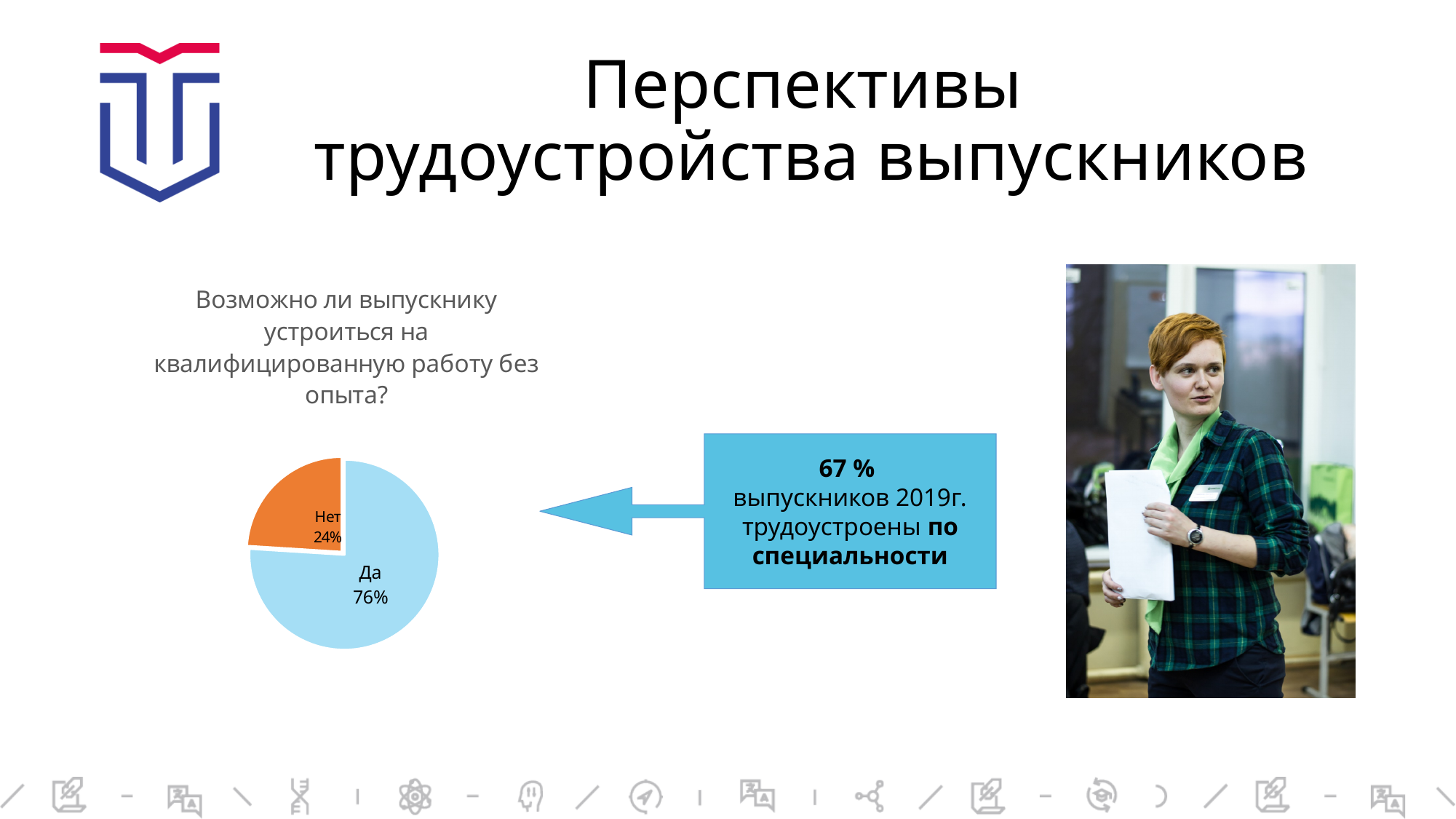
What is the difference between the "Да" and "Нет" shares in the pie chart? 52% What is the title of the pie chart? Возможно ли выпускнику устроиться на квалифицированную работу без опыта? What share of the pie does the "Нет" slice represent? 24% What is the value for "Да" in the pie chart? 76% What is the value for "Нет" in the pie chart? 24% How many slices does the pie chart have? 2 What colour is the "Нет" slice in the pie chart? orange What kind of chart is shown on the slide? pie chart Which slice of the pie chart is the smallest? Нет Which slice of the pie chart is the largest? Да Which is larger in the pie chart, "Да" or "Нет"? Да